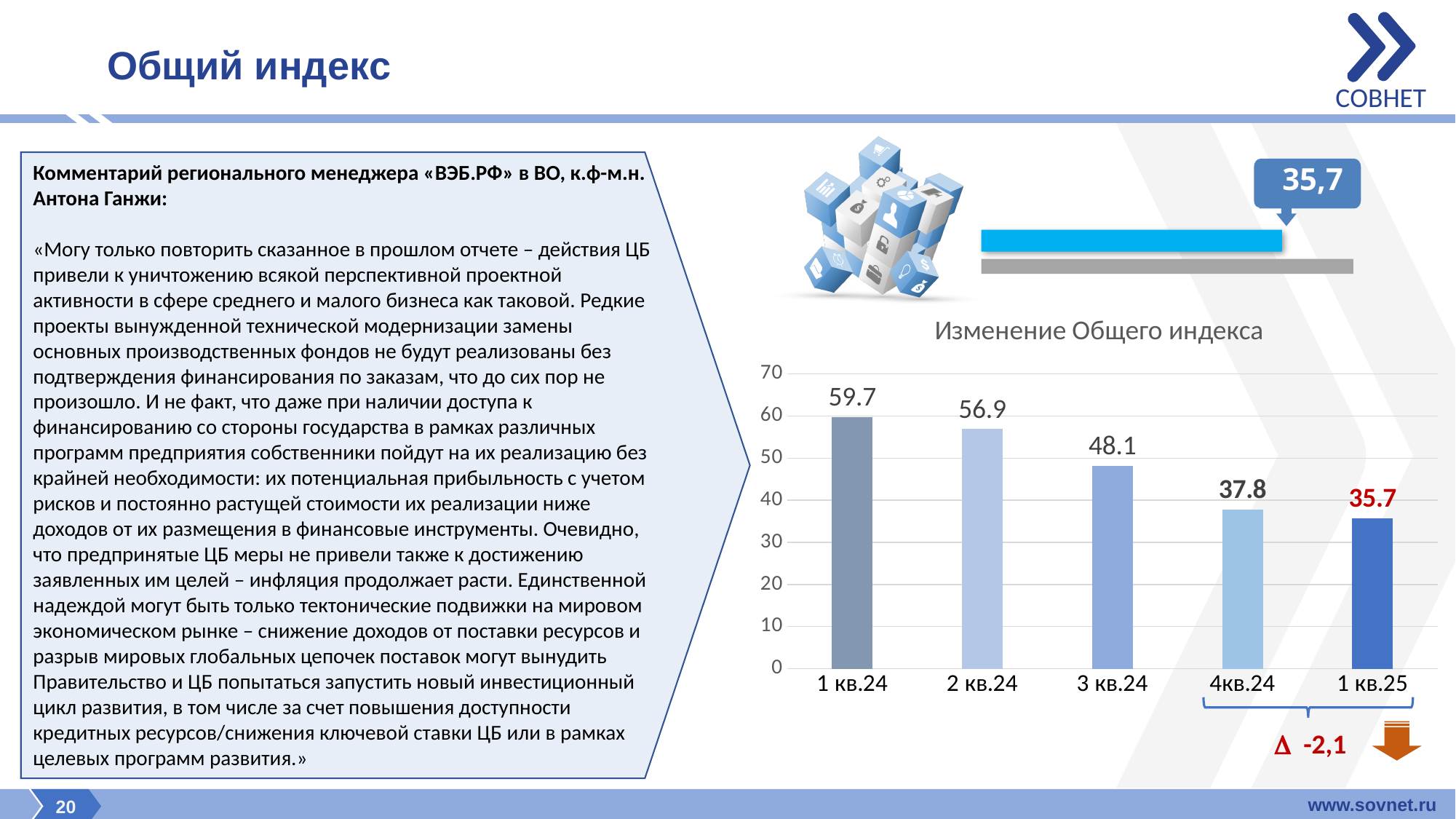
Which is larger, the value for 2 кв.24 or the value for 3 кв.24? 2 кв.24 How many quarters are shown in the chart? 5 Which quarter has the lowest value in the chart? 1 кв.25 Which quarter has the highest value in the chart? 1 кв.24 What is the value for 1 кв.24 in the chart? 59.7 What is the value for 1 кв.25 in the chart? 35.7 What is the difference between the values for 4кв.24 and 1 кв.25? 2.1 What kind of chart is shown on the slide? bar chart Do the values rise or fall from 1 кв.24 to 1 кв.25? fall What is the difference between the values for 1 кв.24 and 2 кв.24? 2.8 What is the value for 3 кв.24 in the chart? 48.1 Is the value for 4кв.24 greater or less than 40? less